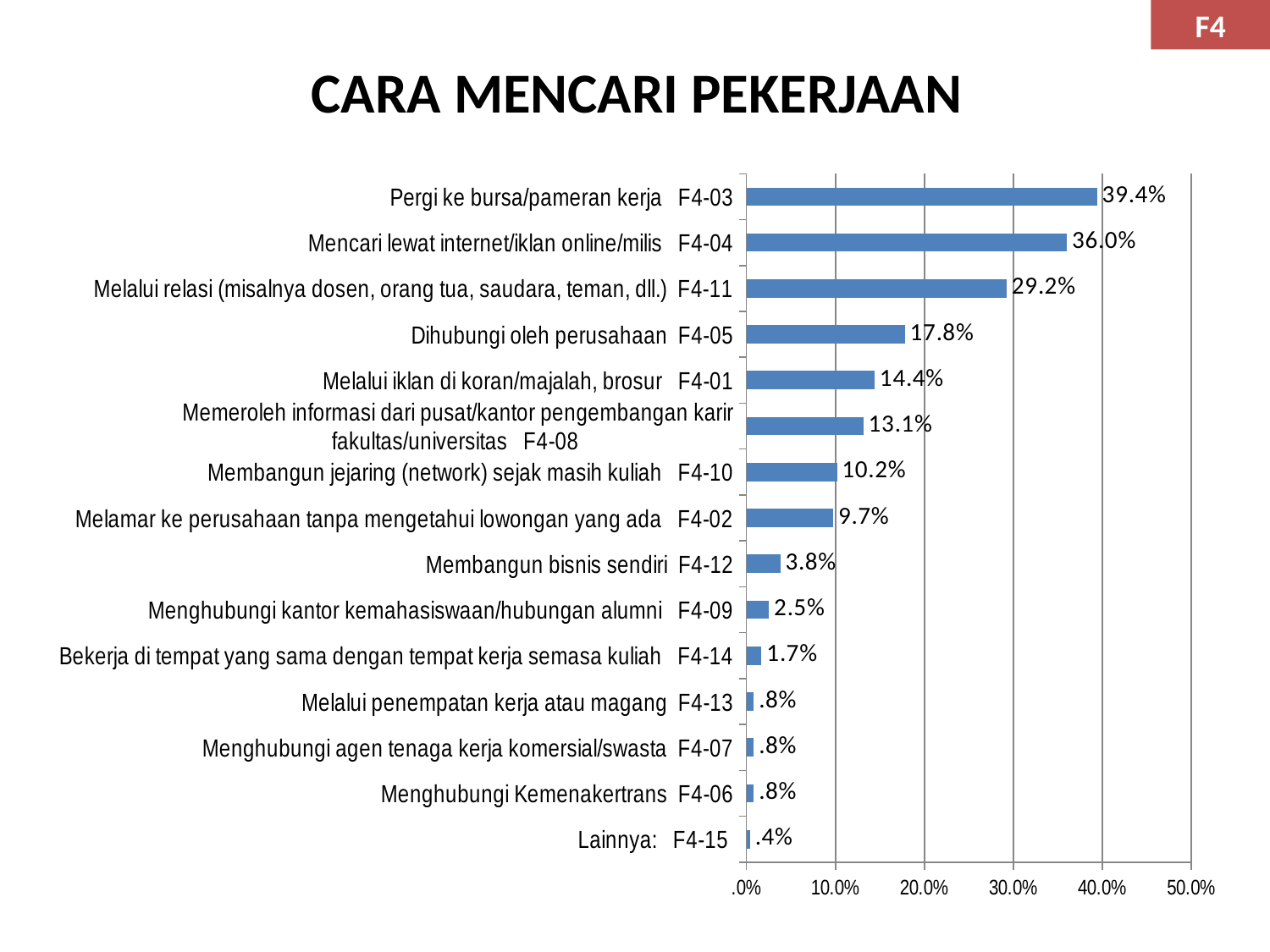
What kind of chart is shown on the slide? bar chart What is the value for "Membangun bisnis sendiri F4-12"? 3.8% What is the title of the slide? CARA MENCARI PEKERJAAN What is the maximum value shown on the horizontal axis? 50.0% Which category has the highest value? Pergi ke bursa/pameran kerja F4-03 Which is larger: the value for "Membangun jejaring (network) sejak masih kuliah F4-10" or "Melamar ke perusahaan tanpa mengetahui lowongan yang ada F4-02"? Membangun jejaring (network) sejak masih kuliah F4-10 Which category has the lowest value? Lainnya: F4-15 What is the value for "Dihubungi oleh perusahaan F4-05"? 17.8% Is the value for "Melalui iklan di koran/majalah, brosur F4-01" greater or less than 10.0%? greater What is the difference between the values for "Mencari lewat internet/iklan online/milis F4-04" and "Melalui relasi (misalnya dosen, orang tua, saudara, teman, dll.) F4-11"? 6.8% What is the value for "Pergi ke bursa/pameran kerja F4-03"? 39.4% How many categories are shown in the chart? 15